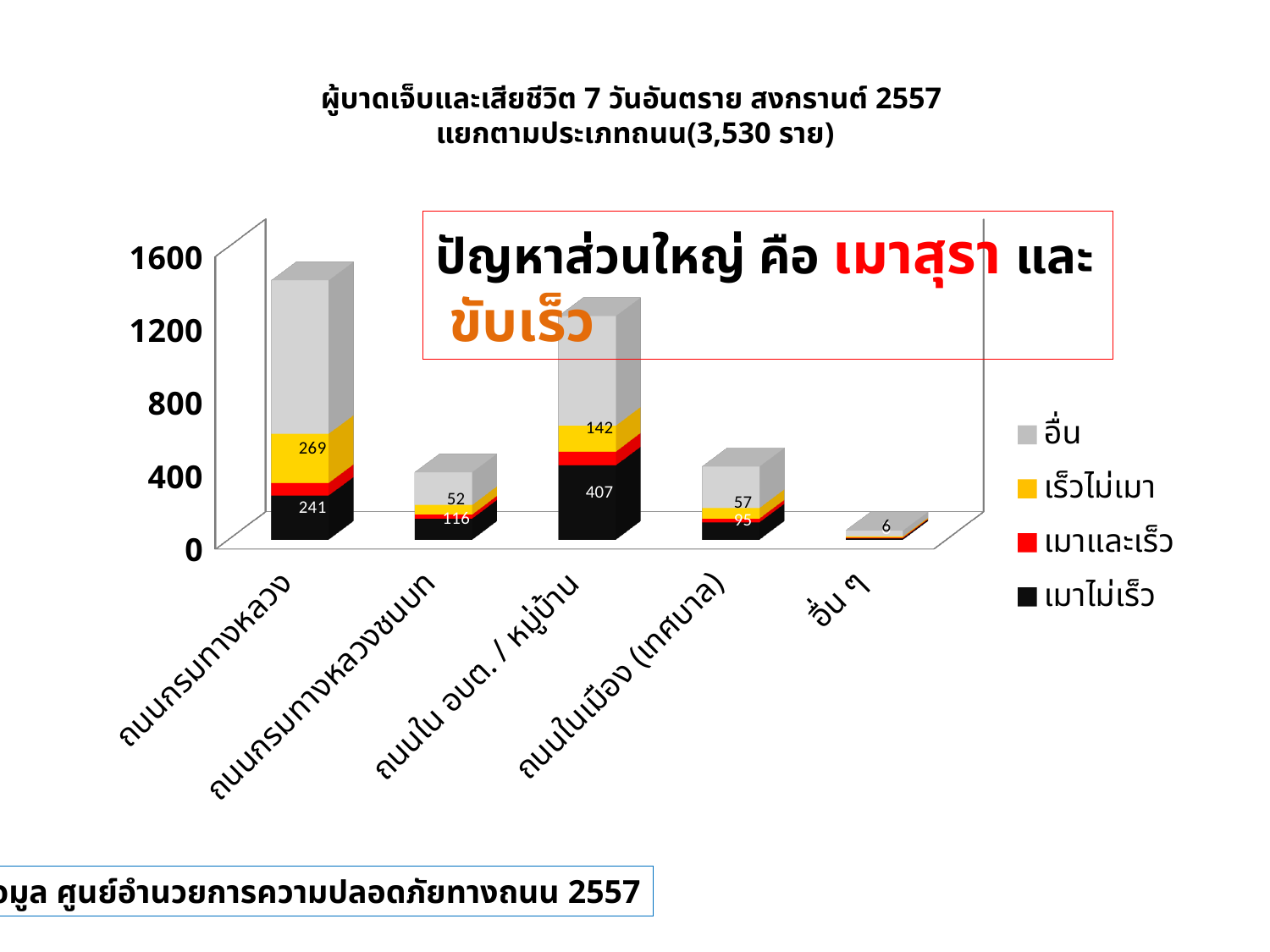
What is the value of เร็วไม่เมา for ถนนกรมทางหลวง? 269 How many road type categories are shown on the x axis? 5 What is the difference between the เมาไม่เร็ว values for ถนนใน อบต. / หมู่บ้าน and ถนนกรมทางหลวง? 166 Which road type has the lowest total stacked bar? อื่น ๆ Which road type has the highest เมาไม่เร็ว value? ถนนใน อบต. / หมู่บ้าน How many series does the legend list? 4 What is the value of เร็วไม่เมา for ถนนกรมทางหลวงชนบท? 52 What is the value of เมาไม่เร็ว for ถนนใน อบต. / หมู่บ้าน? 407 What is the value of เมาไม่เร็ว for ถนนในเมือง (เทศบาล)? 95 What is the value of เมาไม่เร็ว for ถนนกรมทางหลวง? 241 Is the total stacked bar for ถนนกรมทางหลวง greater or less than 1200? greater Which has a larger เร็วไม่เมา value, ถนนกรมทางหลวง or ถนนใน อบต. / หมู่บ้าน? ถนนกรมทางหลวง